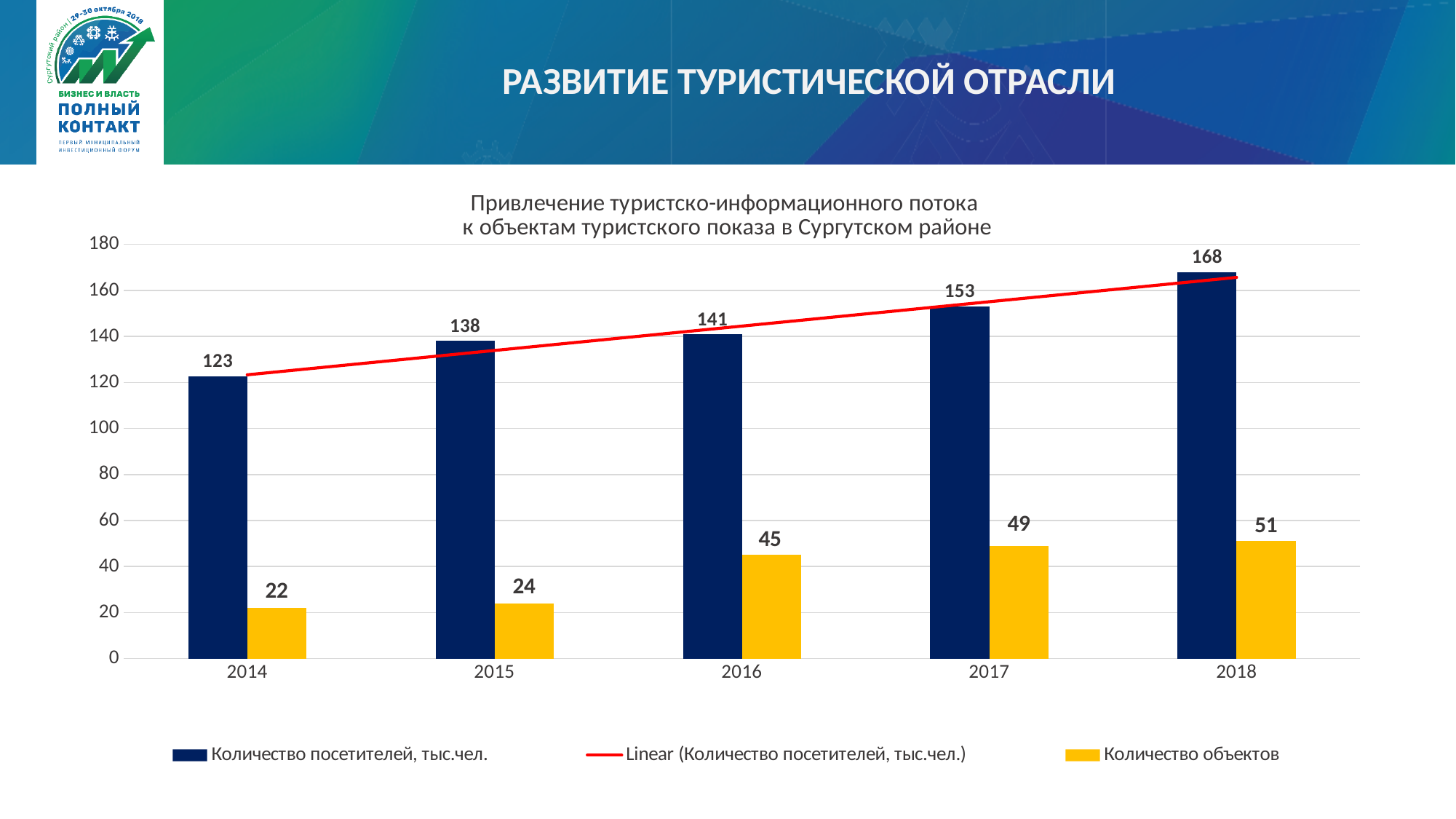
What is the value of "Количество посетителей, тыс.чел." for 2016? 141 Which year has the lowest value for "Количество объектов"? 2014 What kind of chart is shown on the slide? Bar chart with a linear trend line Which year has the highest value for "Количество посетителей, тыс.чел."? 2018 What is the difference between the "Количество посетителей, тыс.чел." values for 2018 and 2014? 45 How many entries does the legend list? 3 What is the value of "Количество объектов" for 2017? 49 Do the values for "Количество посетителей, тыс.чел." rise or fall from 2014 to 2018? Rise Is the value for "Количество посетителей, тыс.чел." in 2017 greater or less than 140? greater Which is larger: "Количество посетителей, тыс.чел." in 2015 or in 2017? 2017 How many years are shown on the x axis? 5 What is the difference between the "Количество объектов" values for 2016 and 2015? 21